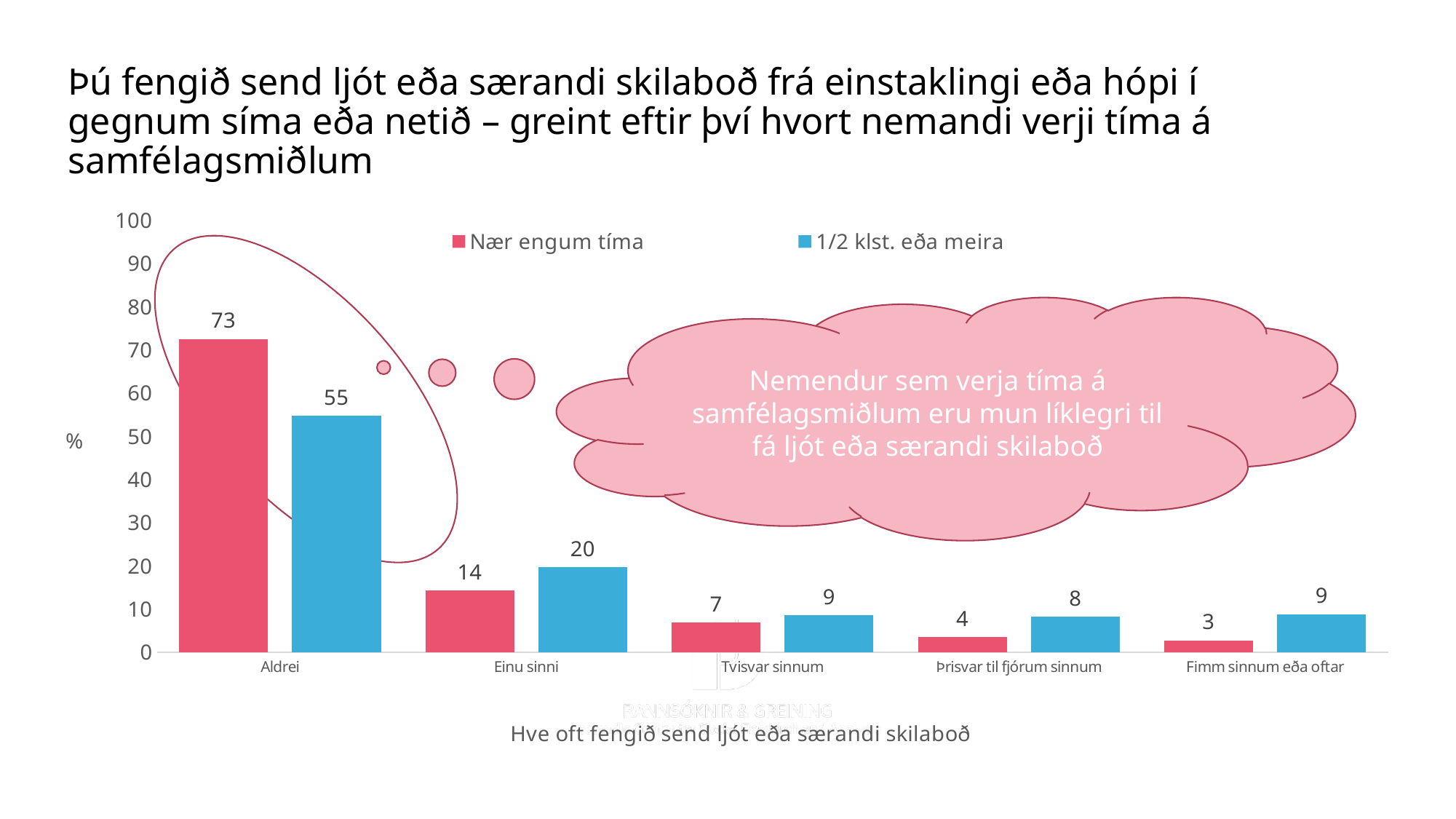
Is the value for 'Nær engum tíma' in the 'Aldrei' category greater or less than 70? greater What is the value for 'Nær engum tíma' in the 'Fimm sinnum eða oftar' category? 3 Which category has the lowest value for the 'Nær engum tíma' series? Fimm sinnum eða oftar What is the x-axis title of the chart? Hve oft fengið send ljót eða særandi skilaboð What kind of chart is shown on the slide? bar chart In the 'Einu sinni' category, which series has the larger value? 1/2 klst. eða meira How many categories are shown on the x axis? 5 What is the value for 'Nær engum tíma' in the 'Aldrei' category? 73 What is the difference between the 'Nær engum tíma' and '1/2 klst. eða meira' values in the 'Aldrei' category? 18 Which category has the highest value for the '1/2 klst. eða meira' series? Aldrei How many series does the legend list? 2 What is the value for '1/2 klst. eða meira' in the 'Einu sinni' category? 20